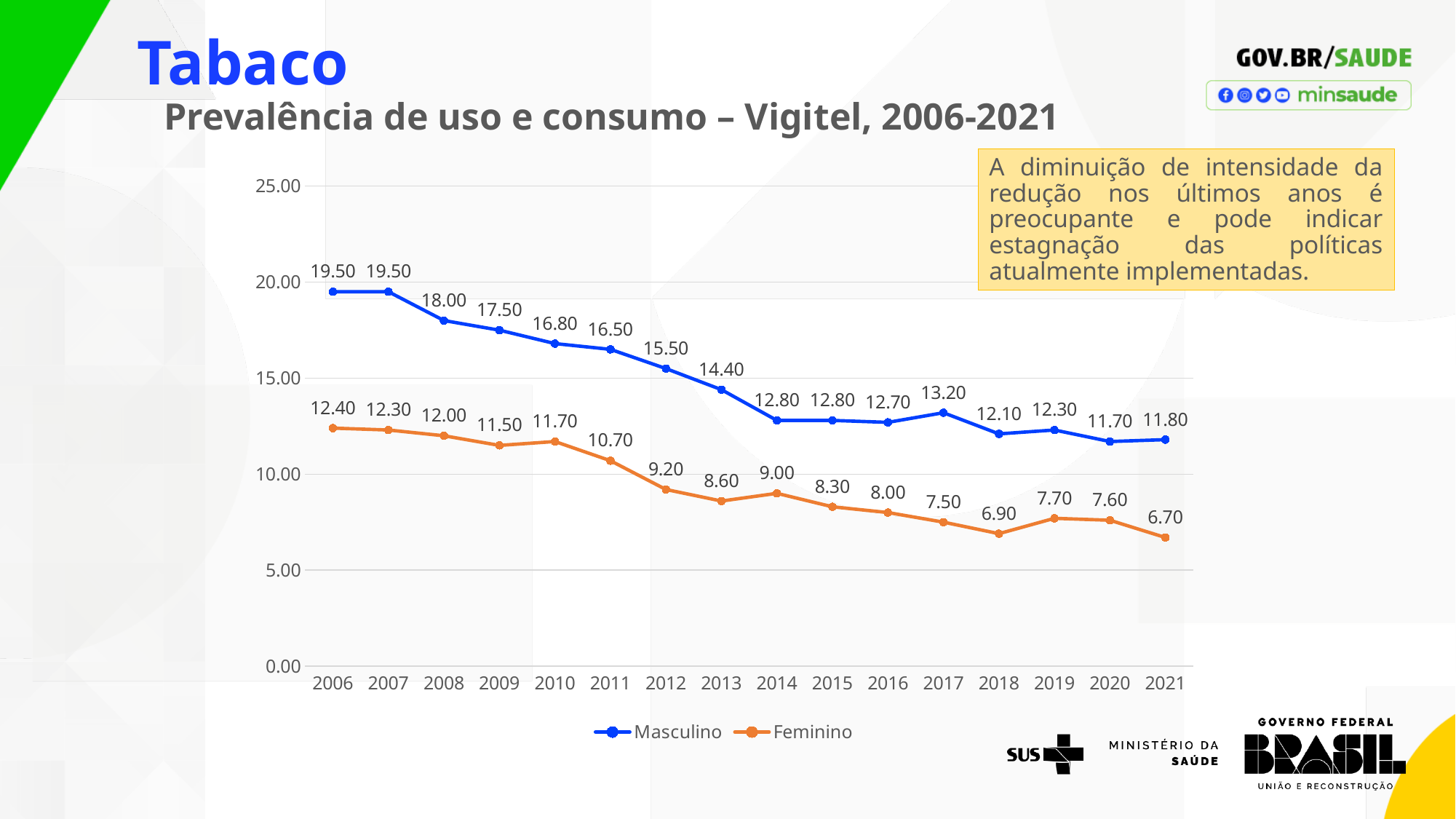
What is the value for Feminino in 2014? 9.00 Which series has the larger value in 2012, Masculino or Feminino? Masculino In which year is the Feminino series lowest? 2021 Does the Masculino series generally rise or fall from 2006 to 2021? Fall What is the value for Feminino in 2021? 6.70 What is the value for Masculino in 2006? 19.50 In which year is the Masculino series highest? 2006 and 2007 What is the difference between the Masculino and Feminino values in 2021? 5.10 How many series does the legend list? 2 How many years are shown on the x axis? 16 What is the value for Masculino in 2017? 13.20 What kind of chart is shown on the slide? Line chart